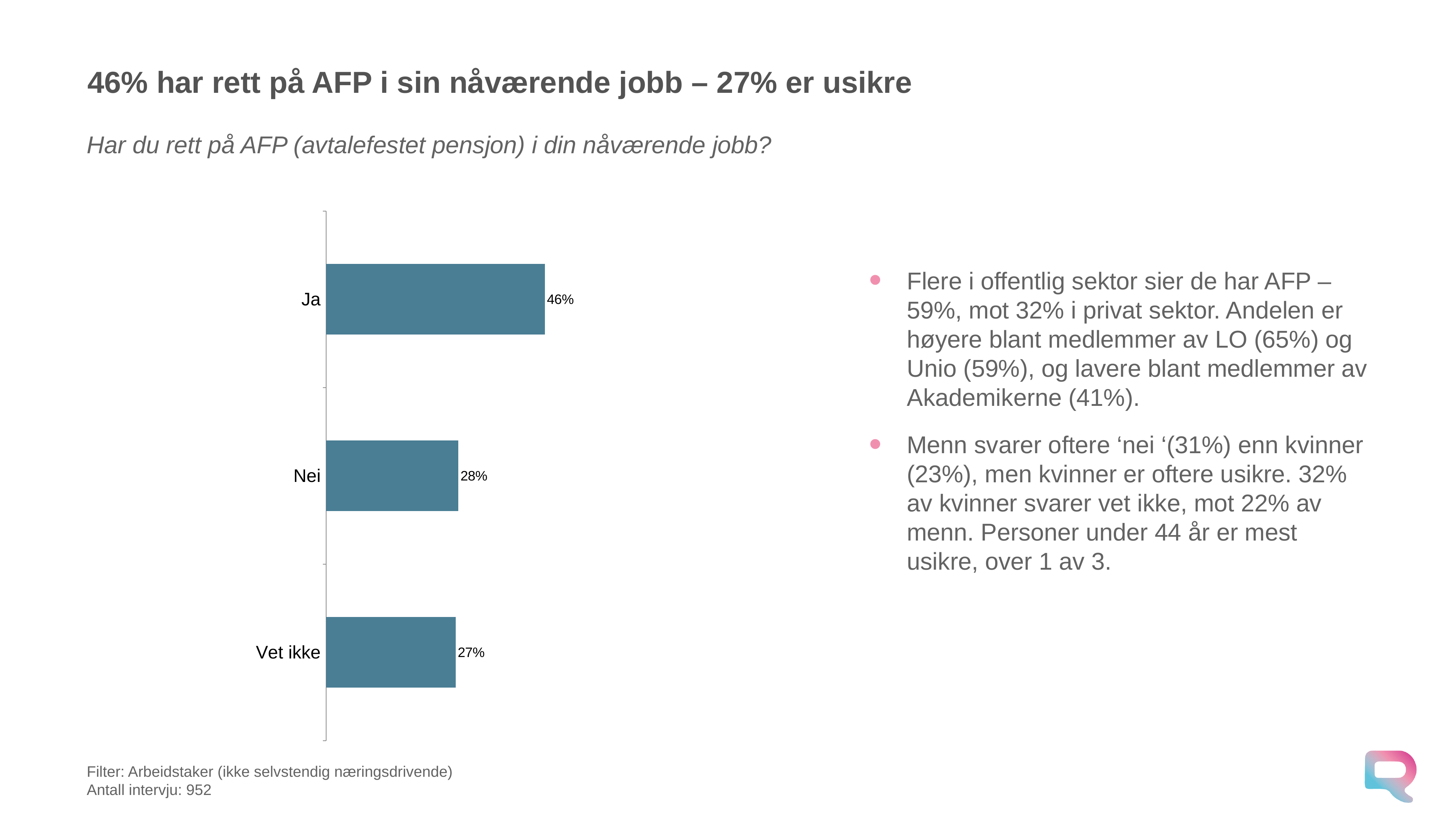
What is the value for "Ja"? 46% What kind of chart is shown on the slide? Bar chart What is the value for "Nei"? 28% How many categories are shown in the chart? 3 What is the difference between the values for "Ja" and "Nei"? 18% What is the value for "Vet ikke"? 27% Which is larger, the value for "Ja" or the value for "Vet ikke"? Ja Which category has the lowest value? Vet ikke What question is the chart based on, as shown in the subtitle? Har du rett på AFP (avtalefestet pensjon) i din nåværende jobb? Which category has the highest value? Ja What is the total of the three values shown in the chart? 101% What is the difference between the values for "Nei" and "Vet ikke"? 1%